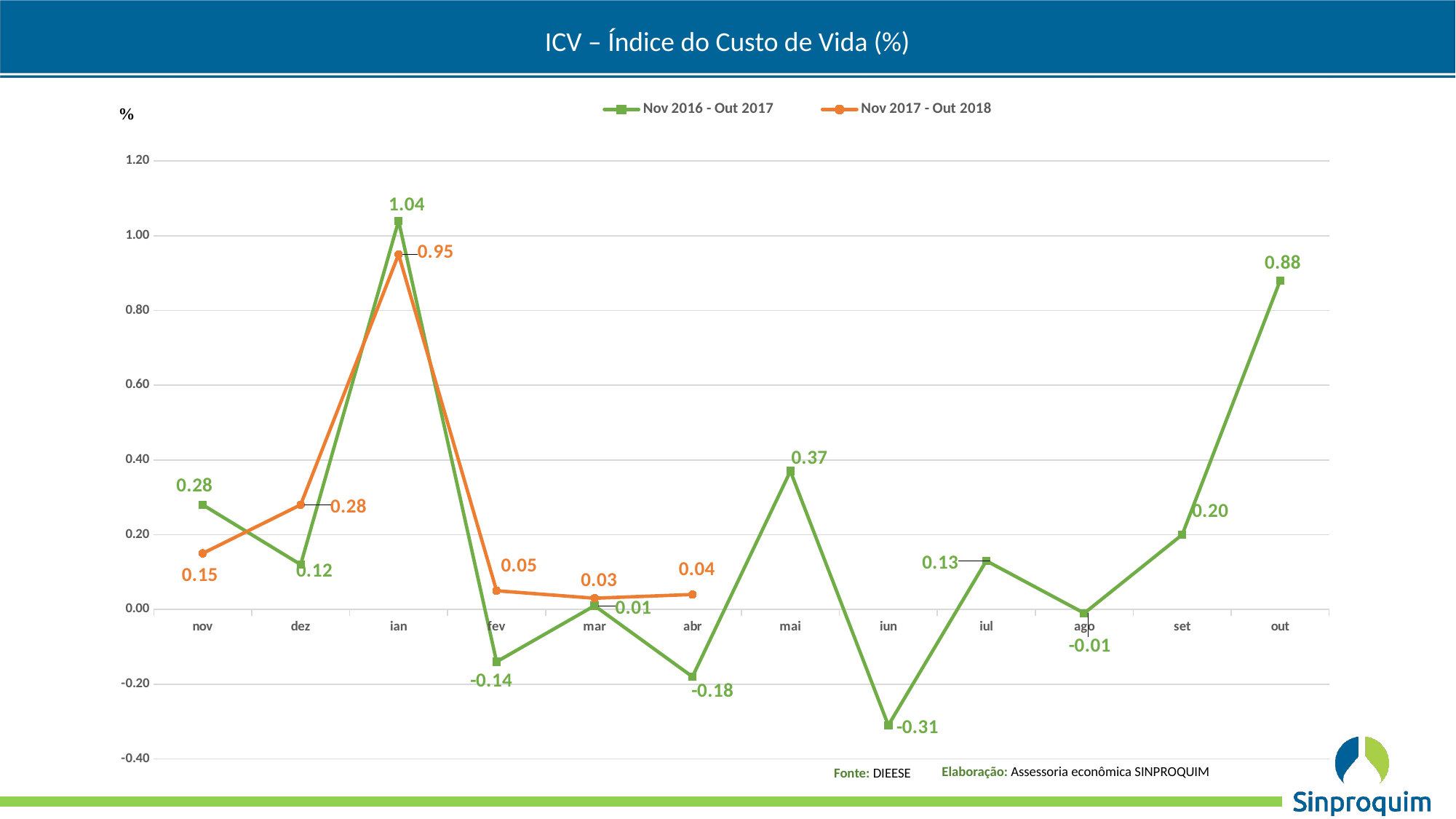
How many series does the legend list? 2 What is the value for jan in the Nov 2016 - Out 2017 series? 1.04 What is the value for jan in the Nov 2017 - Out 2018 series? 0.95 What is the difference between the jan values of the Nov 2016 - Out 2017 and Nov 2017 - Out 2018 series? 0.09 Which month has the lowest value in the Nov 2016 - Out 2017 series? iun How many data points does the Nov 2017 - Out 2018 series have? 6 Which month has the highest value in the Nov 2017 - Out 2018 series? ian What is the value for jun in the Nov 2016 - Out 2017 series? -0.31 In nov, which series has the larger value, Nov 2016 - Out 2017 or Nov 2017 - Out 2018? Nov 2016 - Out 2017 How many months are shown on the x axis? 12 What kind of chart is shown on the slide? line chart What is the title of the chart? ICV – Índice do Custo de Vida (%)